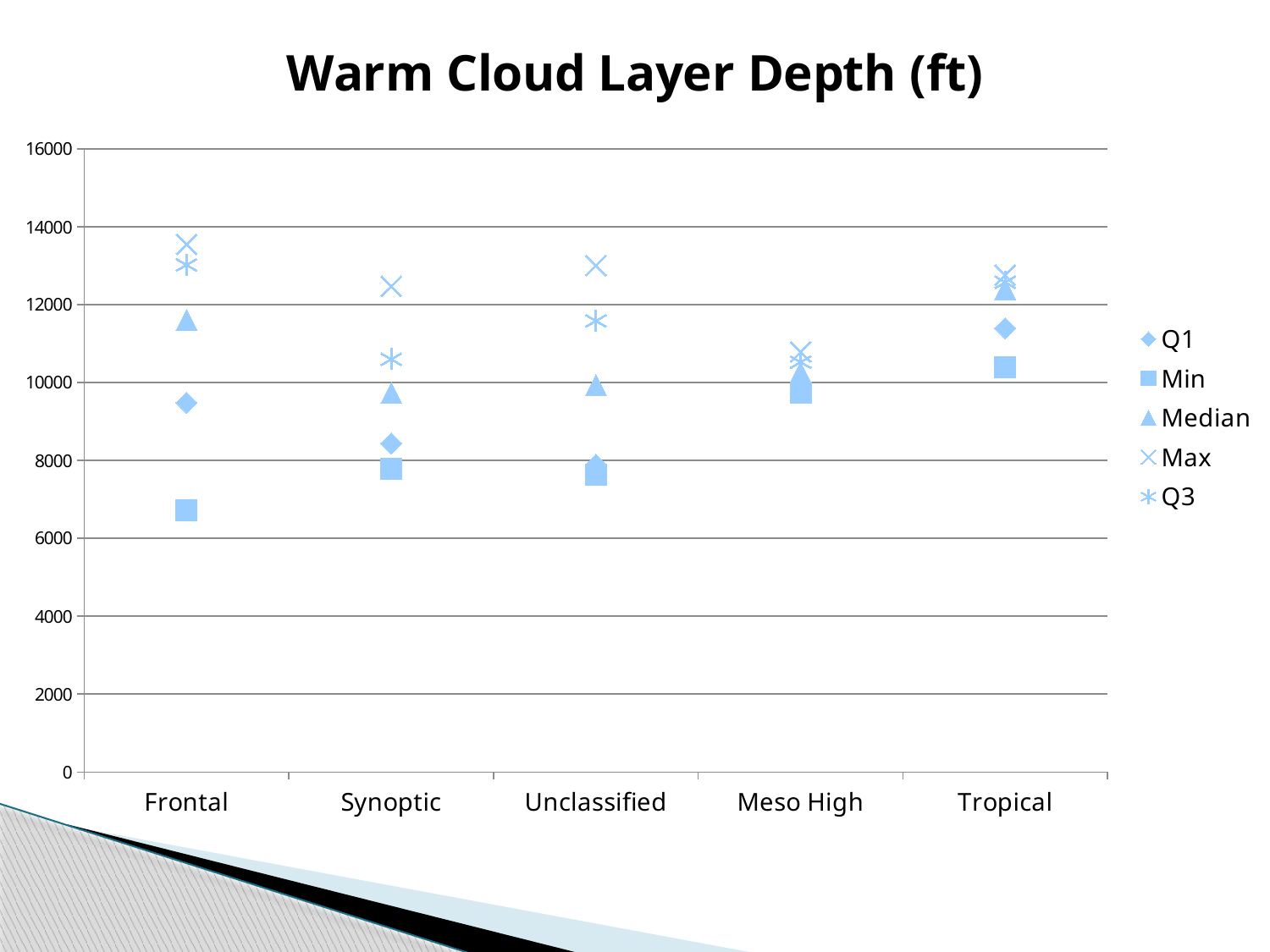
How many series does the legend list? 5 Which category has the lowest Max value? Meso High Which is larger, the Q1 value for Tropical or the Q1 value for Frontal? Tropical Which is larger, the Median value for Frontal or the Median value for Synoptic? Frontal What kind of chart is shown on the slide? scatter chart How many categories are shown on the x axis? 5 Is the Max value for Meso High greater or less than 12000? less Is the Min value for Frontal greater or less than 8000? less Which category has the lowest Min value? Frontal Which category has the highest Max value? Frontal What is the title of the chart? Warm Cloud Layer Depth (ft) Is the Q3 value for Synoptic greater or less than 10000? greater